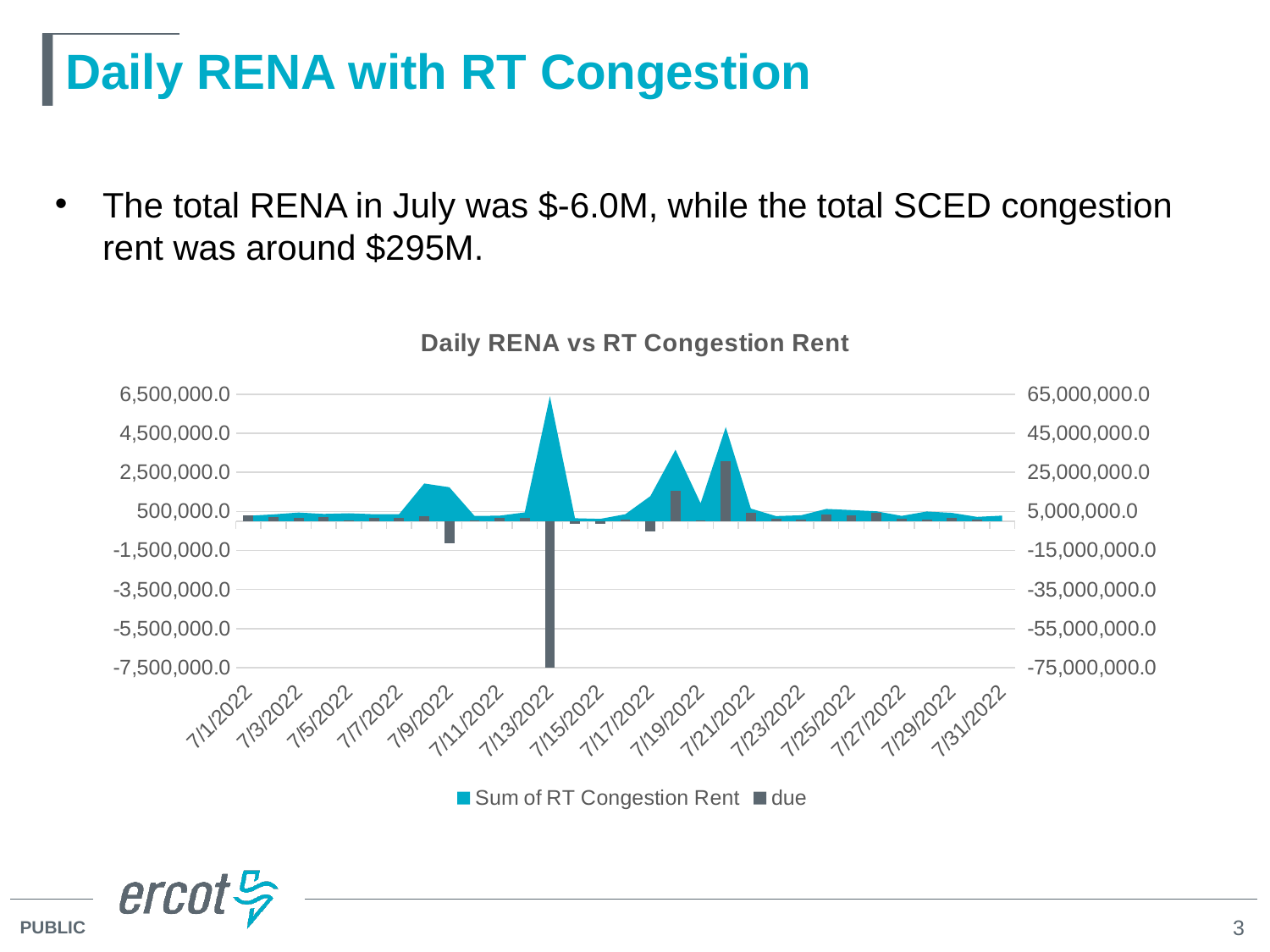
What kind of chart is used to plot the 'due' series? Bar chart How many series does the chart legend list? 2 What is the title of the chart? Daily RENA vs RT Congestion Rent On which date does the 'due' series reach its highest value? 7/20/2022 Which date has the larger Sum of RT Congestion Rent, 7/13/2022 or 7/21/2022? 7/13/2022 Is the Sum of RT Congestion Rent on 7/13/2022 greater or less than 45,000,000.0 on the right axis? greater How many date labels are shown along the x axis? 16 On which date does the Sum of RT Congestion Rent reach its highest value? 7/13/2022 What are the two series named in the chart legend? Sum of RT Congestion Rent and due On which date does the 'due' series reach its lowest value? 7/13/2022 Is the 'due' value on 7/13/2022 greater or less than -5,500,000.0 on the left axis? less